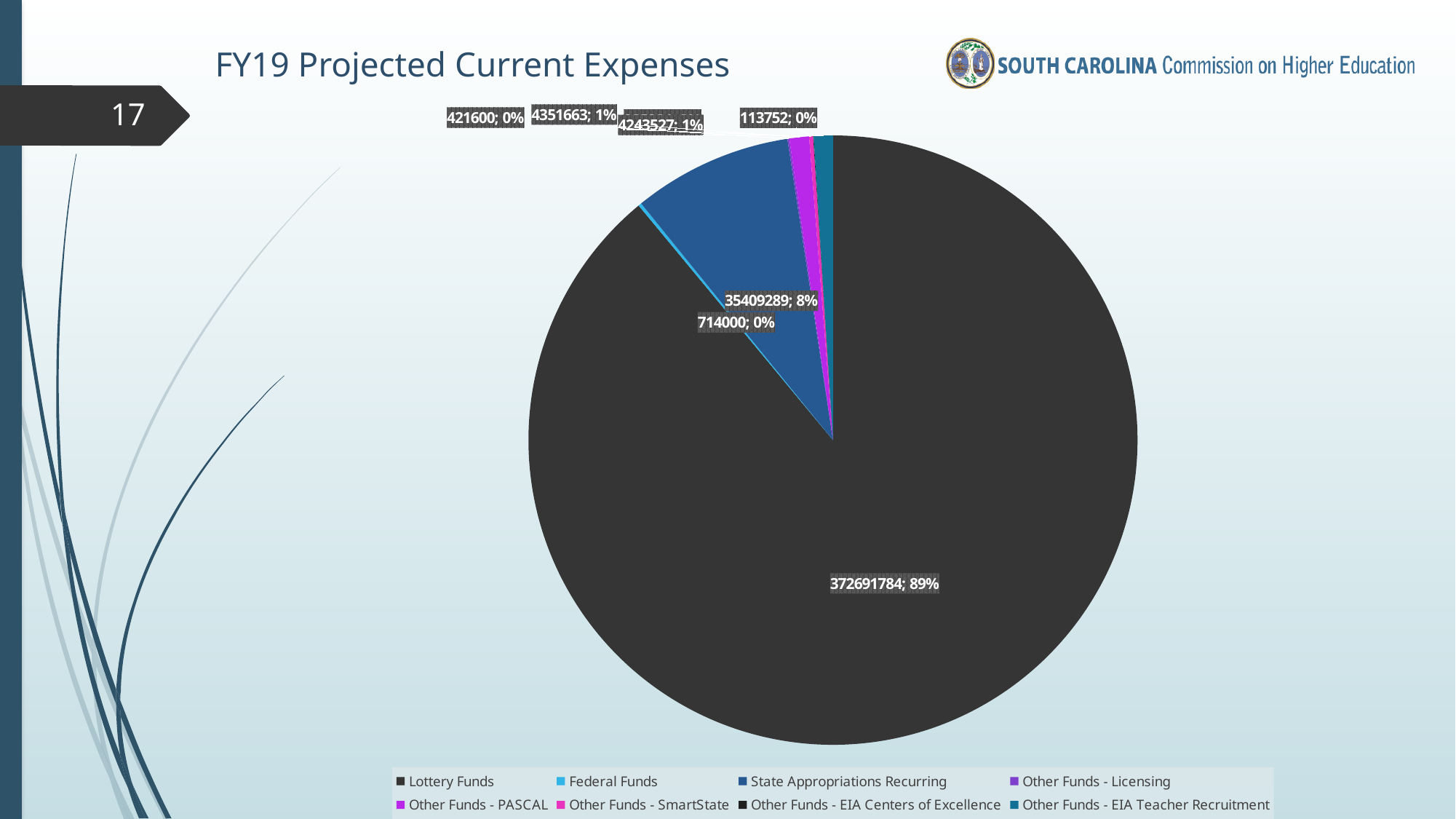
Which legend entry is shown in cyan? Federal Funds What is the value shown for Lottery Funds? 372691784 What share of the pie does State Appropriations Recurring represent? 8% How many categories does the legend list? 8 What is the value shown for State Appropriations Recurring? 35409289 What is the title of the chart? FY19 Projected Current Expenses What share of the pie does Lottery Funds represent? 89% What kind of chart is shown on the slide? pie chart What is the difference between the Lottery Funds value and the State Appropriations Recurring value? 337282495 Which is larger, Lottery Funds or State Appropriations Recurring? Lottery Funds Which category has the largest slice of the pie? Lottery Funds